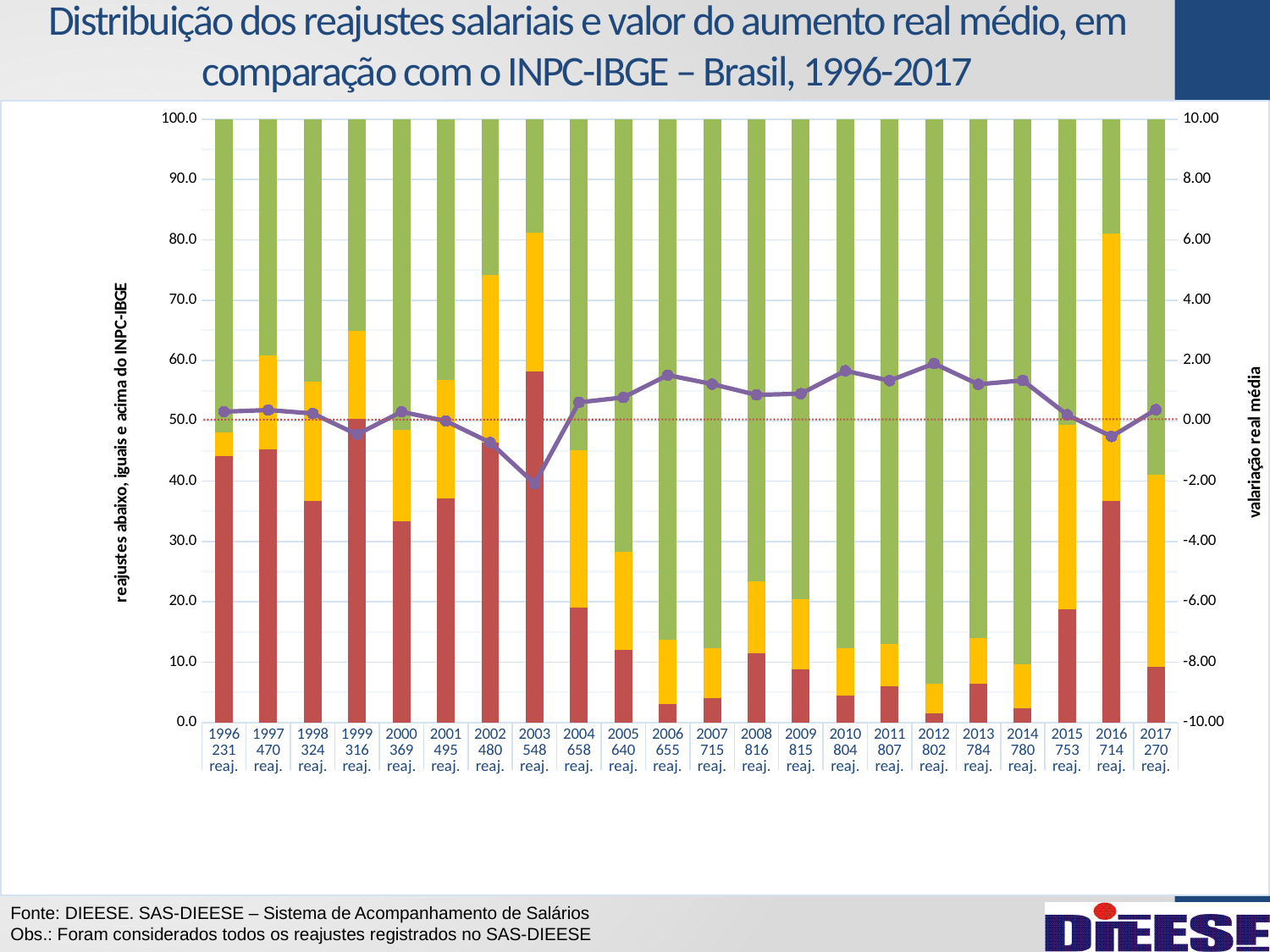
Which year has the higher line value, 2012 or 2016? 2012 Is the red (bottom) segment for 2003 greater or less than 50.0 on the left axis? greater In which year does the line (valariação real média) reach its highest point? 2012 How many years are shown along the x axis of the chart? 22 From 2014 to 2016, does the line rise or fall? fall Which year has the taller red (bottom) segment, 2003 or 1997? 2003 How many readjustments (reaj.) are listed under the 2008 category label? 816 Is the line value for 2016 greater or less than 0.00 on the right axis? less Is the line value for 2003 greater or less than 0.00 on the right axis? less In which year does the line (valariação real média) reach its lowest point? 2003 What kind of chart is shown on the slide? Stacked bar chart with a line